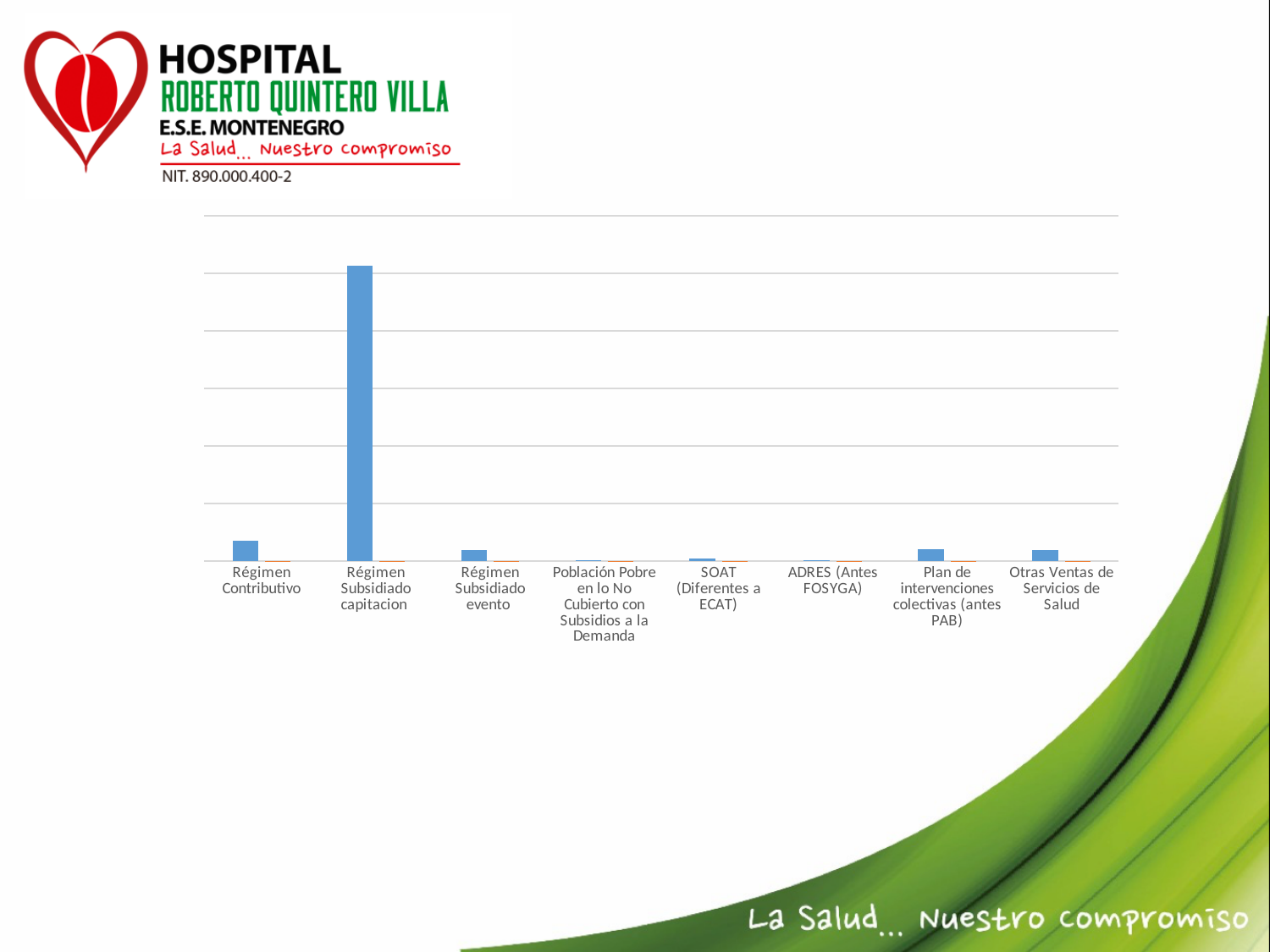
Which category has the highest bar in the chart? Régimen Subsidiado capitacion Which is larger, the value for Otras Ventas de Servicios de Salud or the value for ADRES (Antes FOSYGA)? Otras Ventas de Servicios de Salud Which is larger, the value for Régimen Contributivo or the value for Régimen Subsidiado evento? Régimen Contributivo What is the label of the first category on the x axis of the chart? Régimen Contributivo What kind of chart is shown on the slide? bar chart Which is larger, the value for Régimen Contributivo or the value for SOAT (Diferentes a ECAT)? Régimen Contributivo What colour are the bars in the chart? blue How many categories are shown on the x axis of the chart? 8